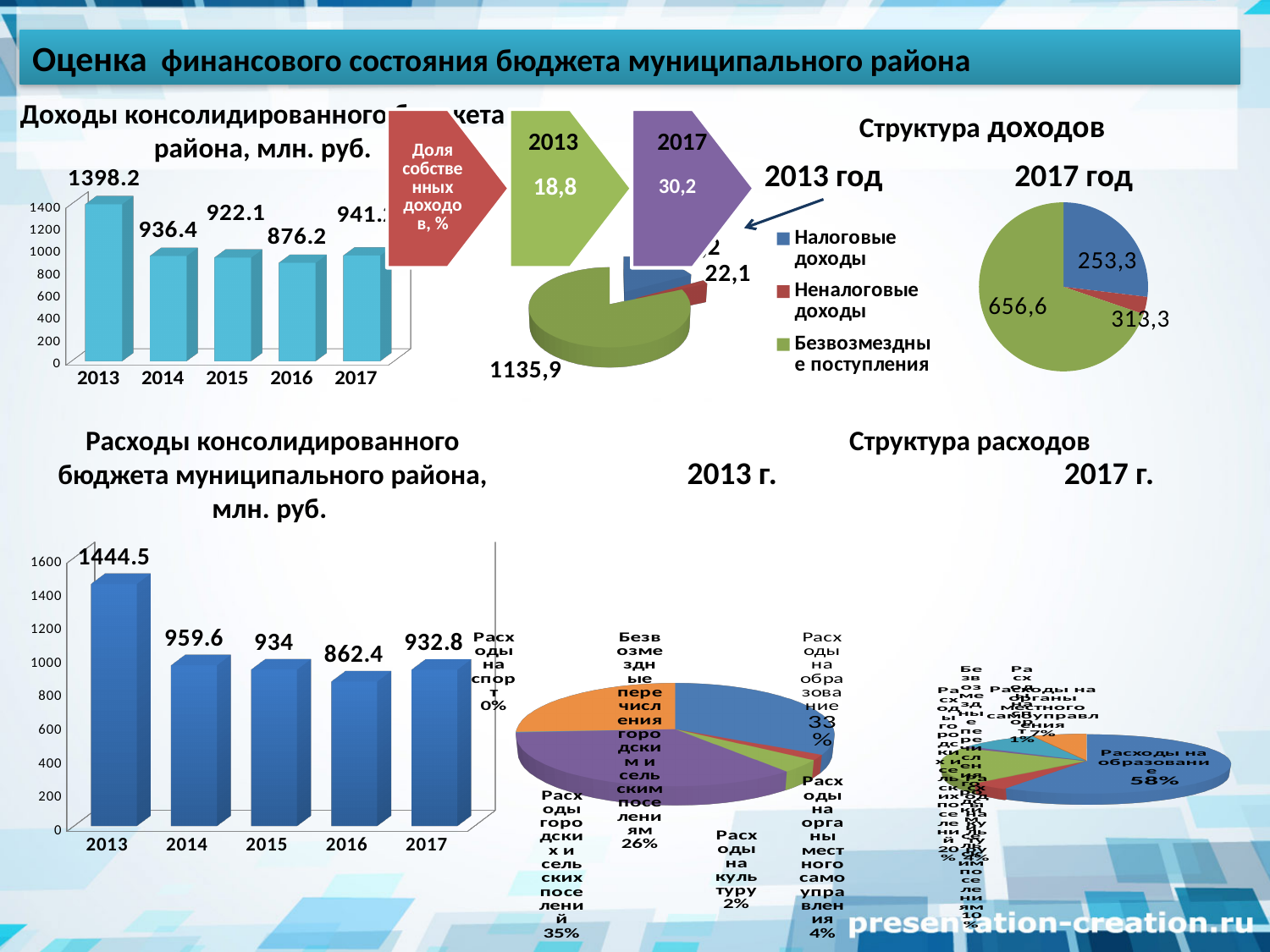
In the chart 'Расходы консолидированного бюджета муниципального района, млн. руб.', which year has the lowest value? 2016 In the chart 'Доходы консолидированного бюджета района, млн. руб.', what is the value for 2013? 1398.2 In the chart 'Доходы консолидированного бюджета района, млн. руб.', which year has the highest value? 2013 In the chart 'Доходы консолидированного бюджета района, млн. руб.', what is the value for 2016? 876.2 What kind of chart is 'Расходы консолидированного бюджета муниципального района, млн. руб.'? bar chart In the chart 'Расходы консолидированного бюджета муниципального района, млн. руб.', is the value for 2014 larger or smaller than the value for 2015? larger In the chart 'Расходы консолидированного бюджета муниципального района, млн. руб.', what is the value for 2017? 932.8 In the chart 'Расходы консолидированного бюджета муниципального района, млн. руб.', how many years are shown on the x axis? 5 In the 'Структура доходов 2013 год' pie chart, what is the value for Безвозмездные поступления? 1135,9 In the chart 'Доходы консолидированного бюджета района, млн. руб.', what is the difference between the values for 2014 and 2015? 14.3 How many entries does the legend of the 'Структура доходов' pie charts list? 3 In the 'Структура расходов 2013 г.' pie chart, what share is Расходы на образование? 33%